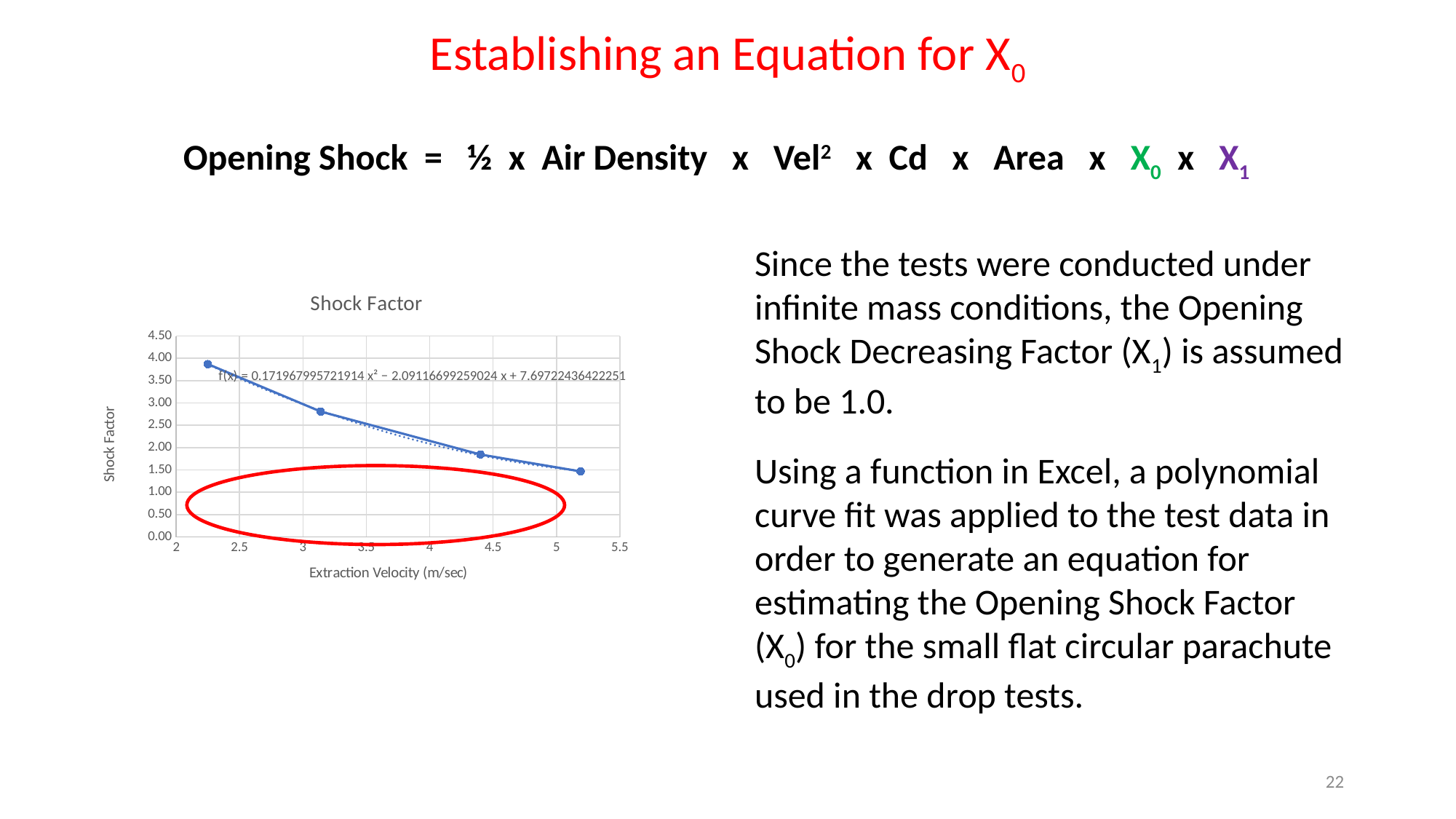
Is the Shock Factor value for the second data point from the left greater or less than 2.50? greater Do the Shock Factor values rise or fall as Extraction Velocity increases? fall Is the Shock Factor value for the rightmost data point greater or less than 2.00? less Is the Shock Factor value for the leftmost data point greater or less than 3.50? greater What is the label on the x axis of the chart? Extraction Velocity (m/sec) What kind of chart is shown on the slide? line chart Which has the larger Shock Factor value, the leftmost data point or the rightmost data point? the leftmost data point What is the title of the chart? Shock Factor How many data points are plotted in the Shock Factor chart? 4